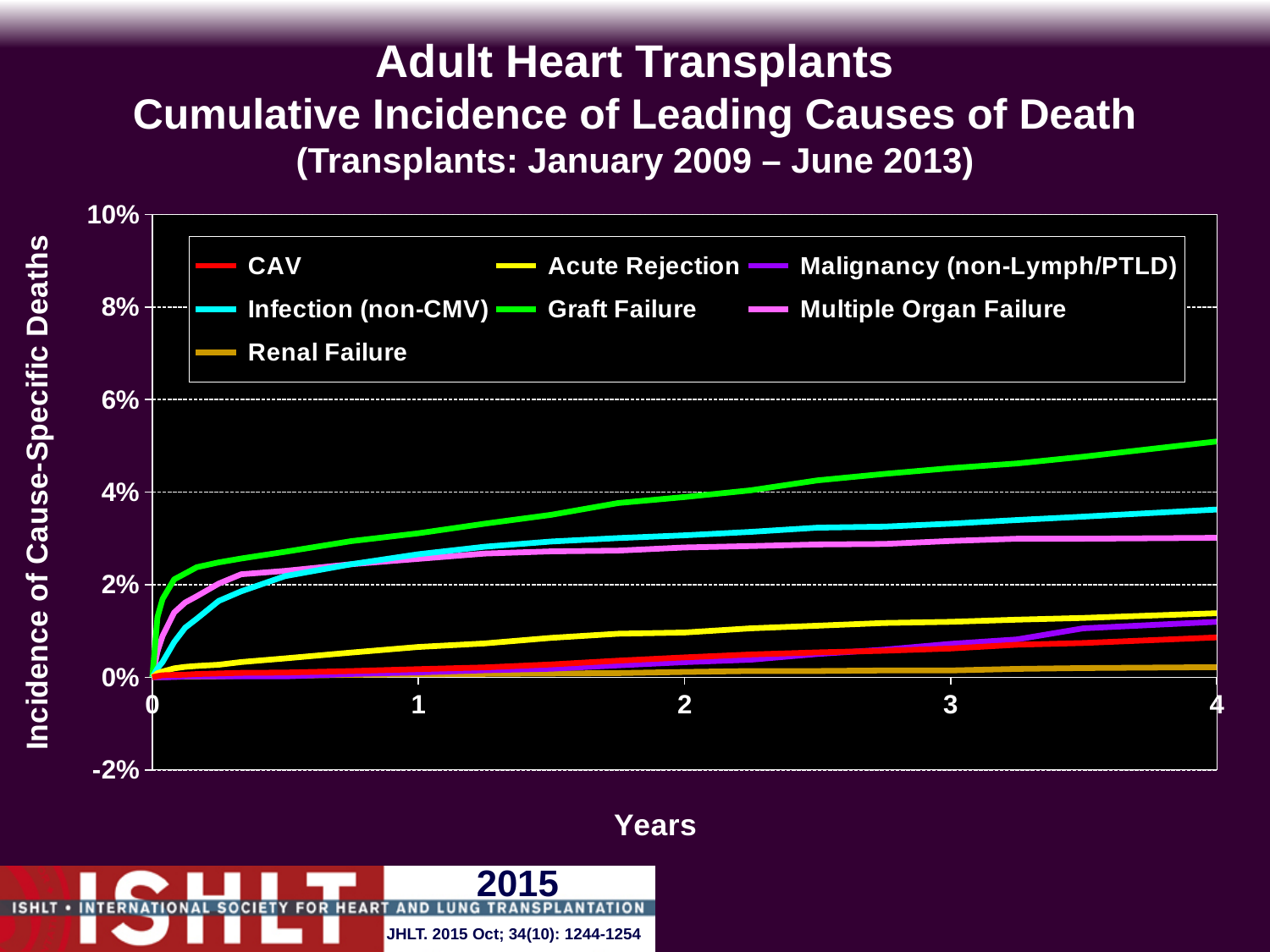
Which cause of death has the highest cumulative incidence at 4 years? Graft Failure Is the cumulative incidence for Infection (non-CMV) at 4 years greater or less than 4%? less Is the cumulative incidence for Graft Failure at 4 years greater or less than 4%? greater At 4 years, which is higher: Infection (non-CMV) or Multiple Organ Failure? Infection (non-CMV) What colour is the line for Graft Failure in the legend? Green Does the cumulative incidence for Graft Failure rise or fall over the years shown? Rise Is the cumulative incidence for Acute Rejection at 4 years greater or less than 2%? less What kind of chart is shown on the slide? Line chart Which cause of death has the lowest cumulative incidence at 4 years? Renal Failure How many series does the legend list? 7 What transplant period does the chart title state? January 2009 – June 2013